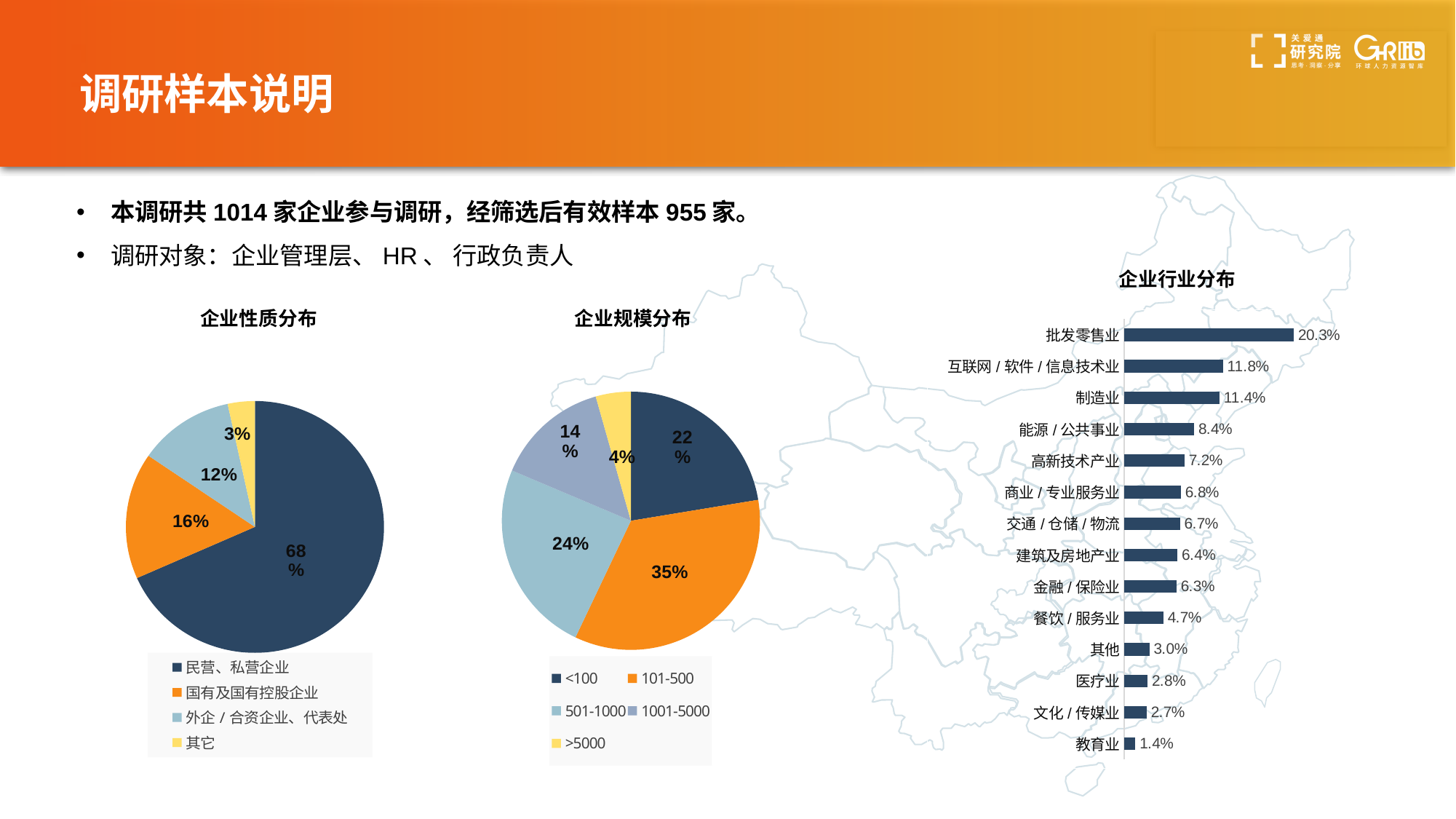
In the 企业规模分布 pie chart, what is the value for the 1001-5000 category? 14% What type of chart is the 企业行业分布 chart? bar chart In the 企业行业分布 chart, what is the value for 制造业? 11.4% In the 企业行业分布 chart, which industry has the highest value? 批发零售业 In the 企业规模分布 pie chart, what share do companies with 101-500 employees account for? 35% In the 企业性质分布 pie chart, how many categories does the legend list? 4 In the 企业性质分布 pie chart, which category has the smallest share? 其它 In the 企业性质分布 pie chart, what share do 民营、私营企业 account for? 68% In the 企业性质分布 pie chart, what is the value for 国有及国有控股企业? 16% In the 企业规模分布 pie chart, which is larger, the <100 share or the >5000 share? <100 In the 企业规模分布 pie chart, what is the difference between the 501-1000 share and the <100 share? 2% In the 企业行业分布 chart, what is the difference between 批发零售业 and 互联网 / 软件 / 信息技术业? 8.5%